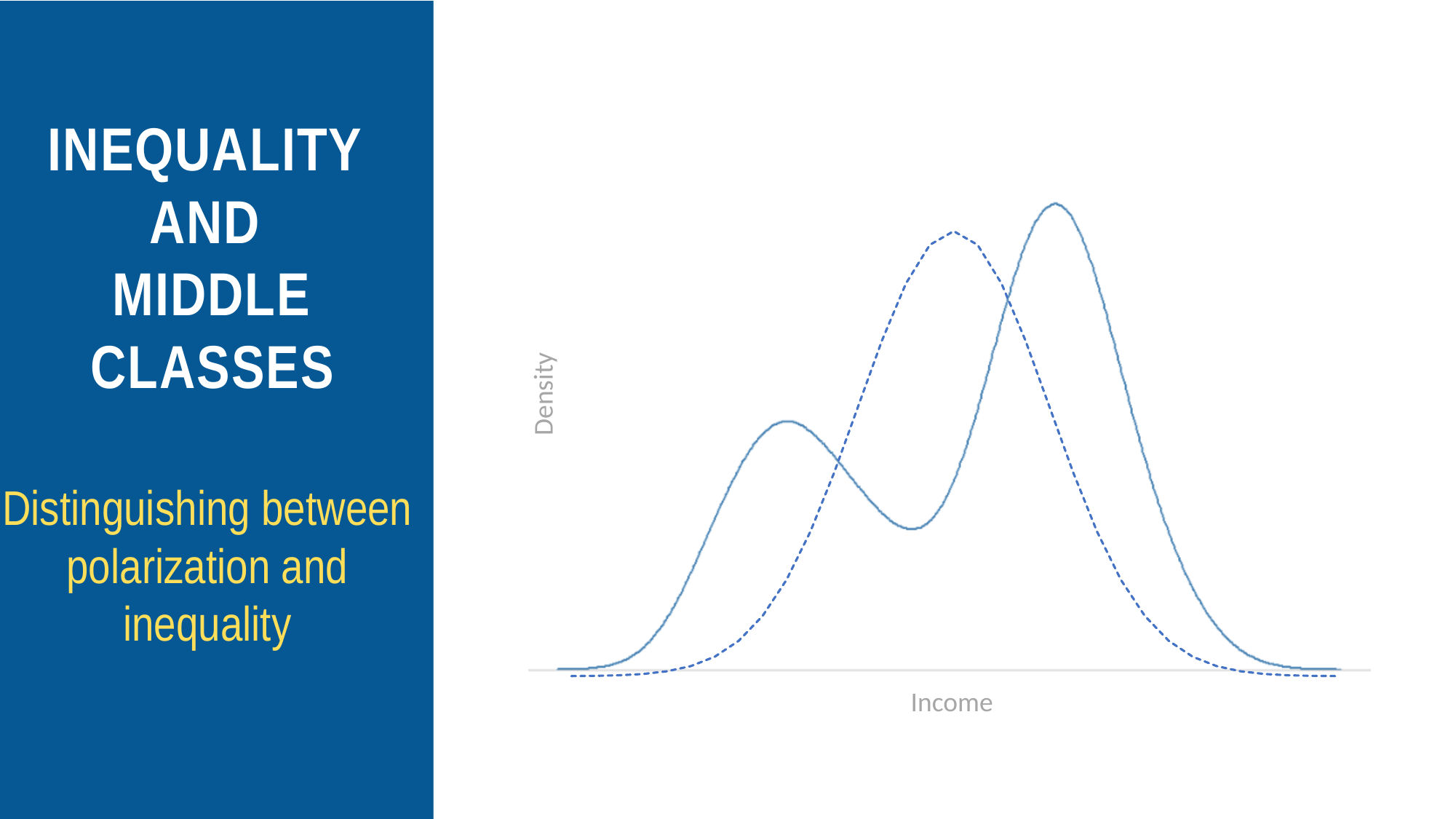
Does the dashed curve rise or fall as income increases beyond its peak? fall Which of the solid curve's two peaks is higher, the left one or the right one? the right one How many peaks does the dashed curve have? 1 Which curve reaches the higher maximum density, the solid curve or the dashed curve? the solid curve What is the label of the vertical axis of the chart? Density What is the label of the horizontal axis of the chart? Income Does the chart display a legend? No How many curves are plotted on the chart? 2 How many peaks does the solid curve have? 2 What kind of chart is shown on the slide? line chart